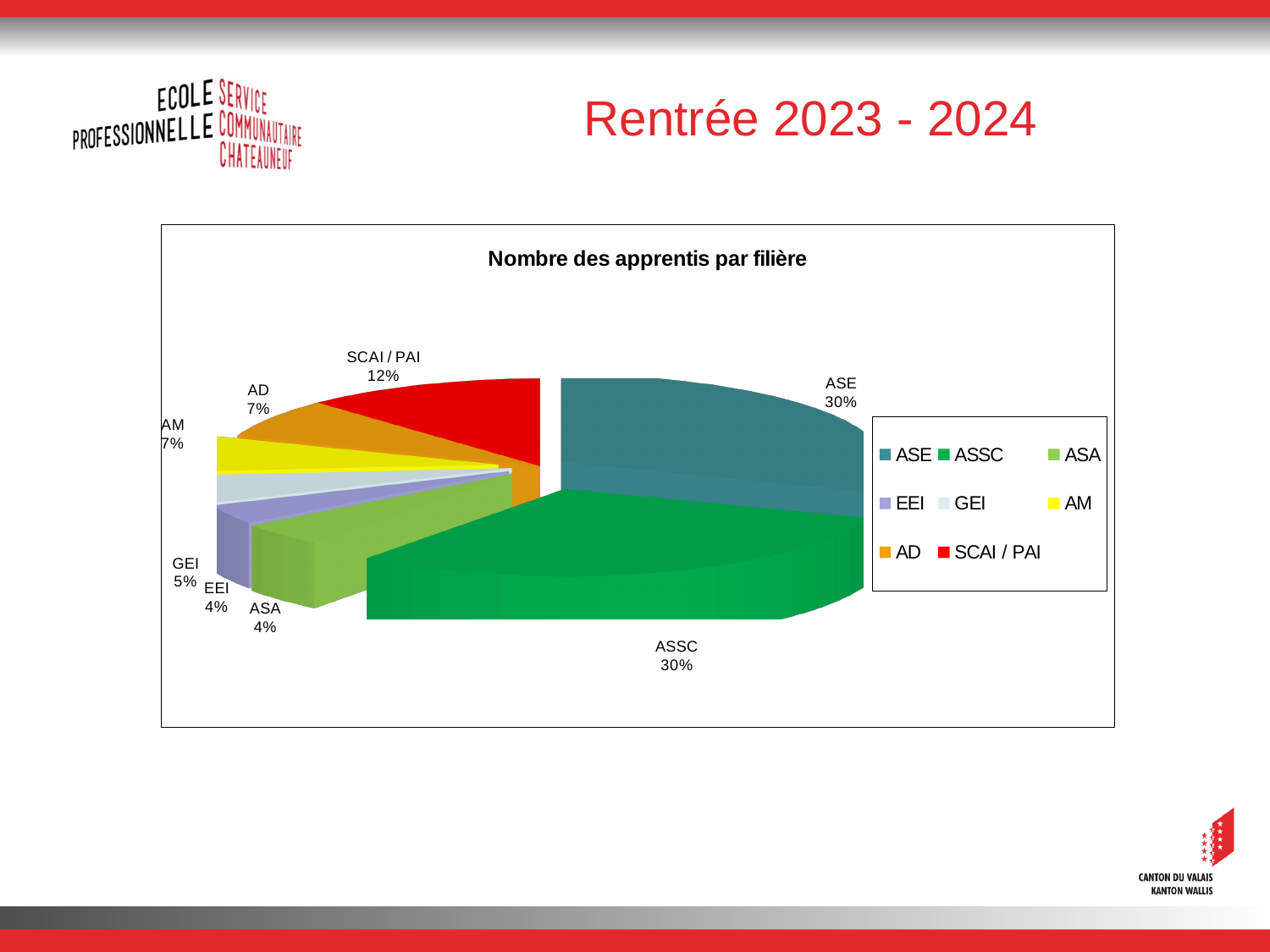
What share of the pie does SCAI / PAI represent? 12% How many filières (slices) are shown in the pie chart? 8 Which has the larger share, GEI or EEI? GEI Which has the larger share, AM or ASA? AM What type of chart is shown on the slide? Pie chart What is the difference in percentage points between ASE and GEI? 25% What share of the pie does ASSC represent? 30% What percentage is shown for AM? 7% What is the value shown for GEI? 5% What is the title of the chart? Nombre des apprentis par filière What is the difference in percentage points between SCAI / PAI and AD? 5% What percentage of apprentices are in the ASE filière? 30%